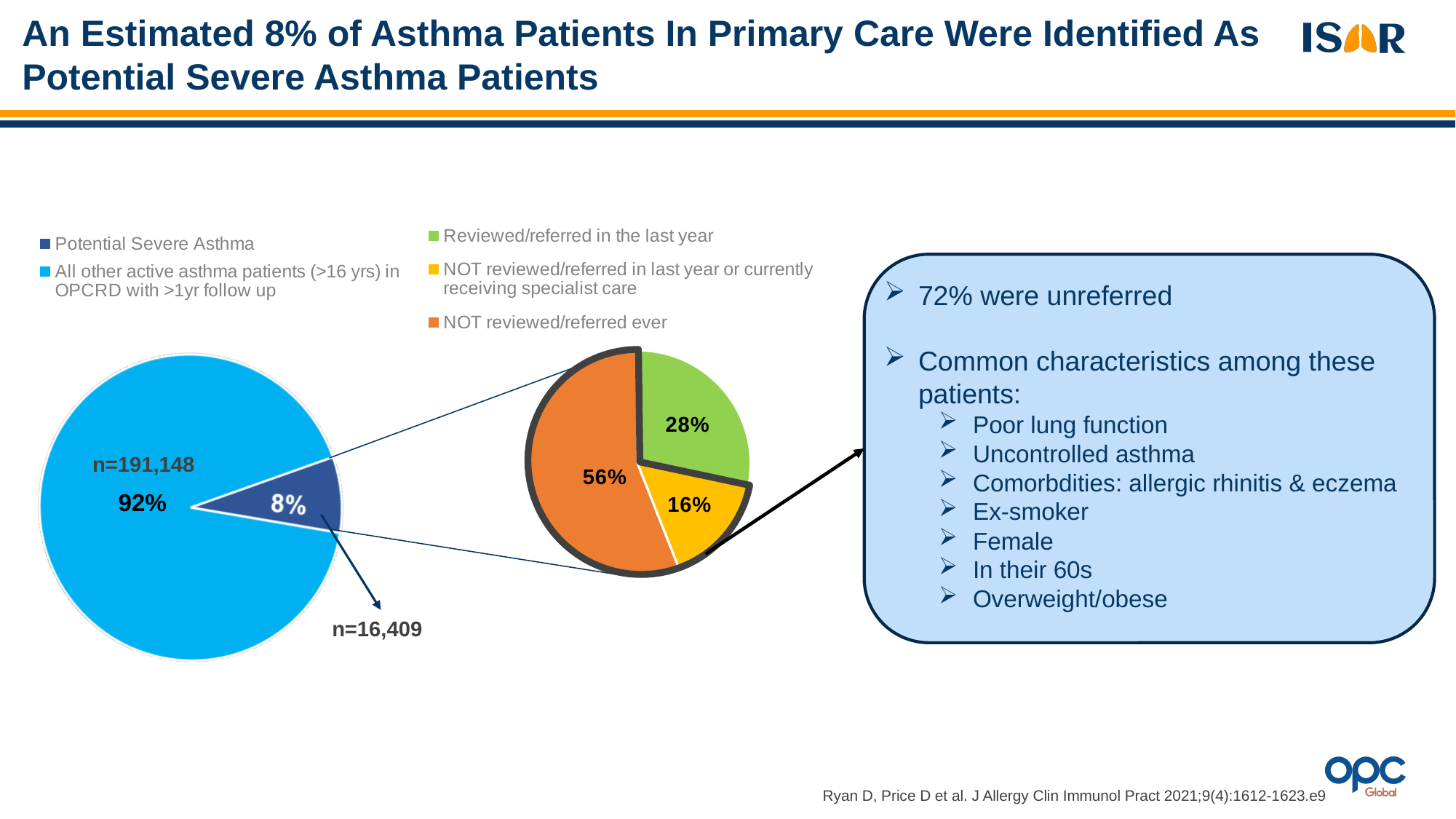
In the right pie chart, what is the difference in percentage points between the NOT reviewed/referred ever slice and the reviewed/referred in the last year slice? 28 What kind of chart is the left chart on the slide? Pie chart In the right pie chart, what percentage were NOT reviewed/referred in the last year or currently receiving specialist care? 16% How many slices does the right pie chart have? 3 In the right pie chart, which category has the largest slice? NOT reviewed/referred ever In the left pie chart, what is the n value shown for the Potential Severe Asthma slice? n=16,409 In the right pie chart, what percentage were reviewed/referred in the last year? 28% In the right pie chart, which category has the smallest slice? NOT reviewed/referred in last year or currently receiving specialist care In the left pie chart, what is the n value shown for all other active asthma patients? n=191,148 In the right pie chart, what percentage were NOT reviewed/referred ever? 56% In the left pie chart, which slice is larger: Potential Severe Asthma or all other active asthma patients? All other active asthma patients